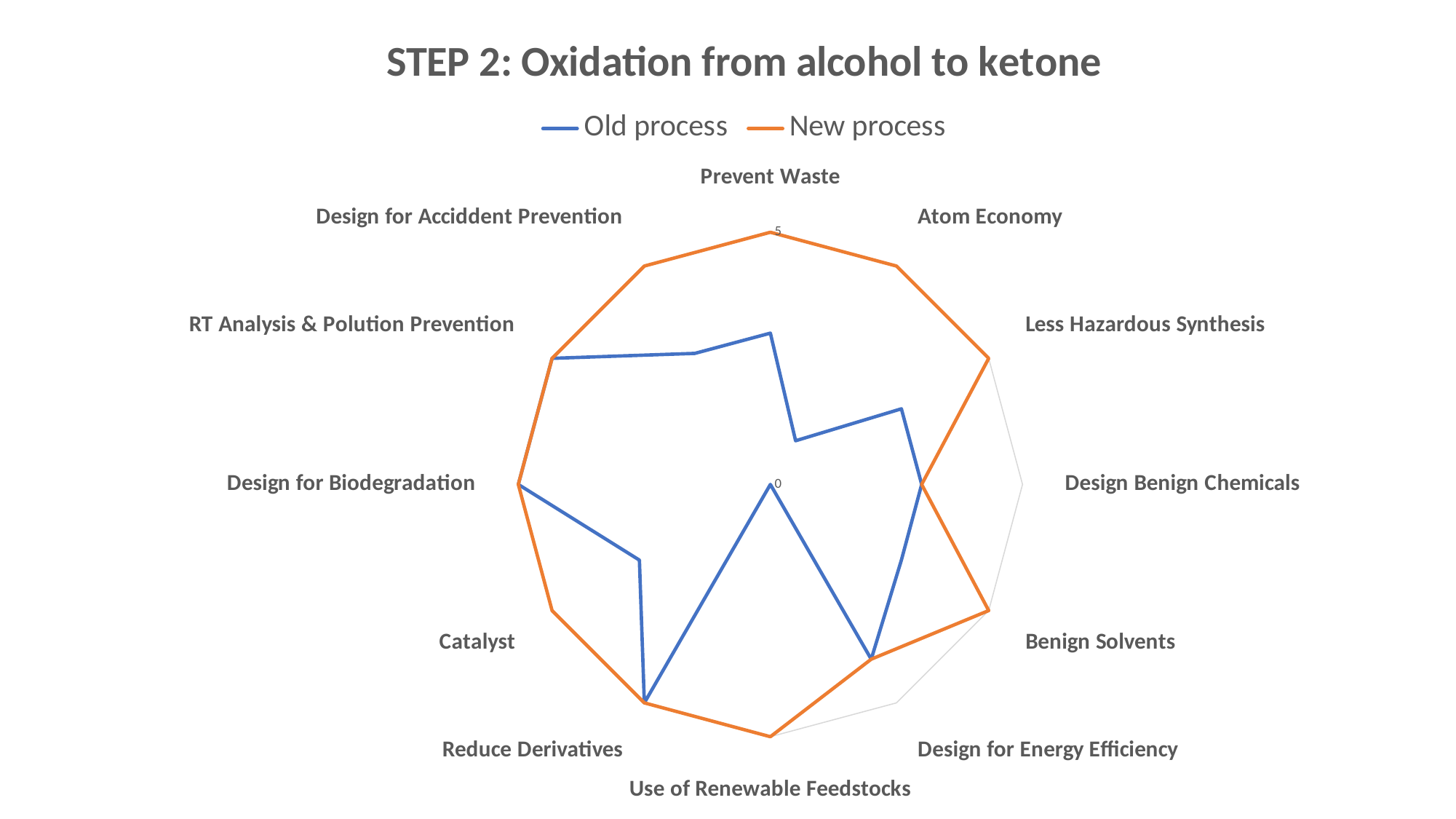
Is the Old process value for Atom Economy greater or less than 5? less Which colour represents the New process in the legend? Orange Which series has the larger value for Atom Economy, Old process or New process? New process What is the value of the New process for Prevent Waste? 5 What type of chart is shown on the slide? Radar chart What is the difference between the New process and Old process values for Use of Renewable Feedstocks? 5 How many series does the legend list? 2 What is the value of the Old process for Use of Renewable Feedstocks? 0 How many categories (axes) does the radar chart have? 12 Which category has the lowest value for the Old process? Use of Renewable Feedstocks What is the title of the chart? STEP 2: Oxidation from alcohol to ketone Which category has the lowest value for the New process? Design Benign Chemicals